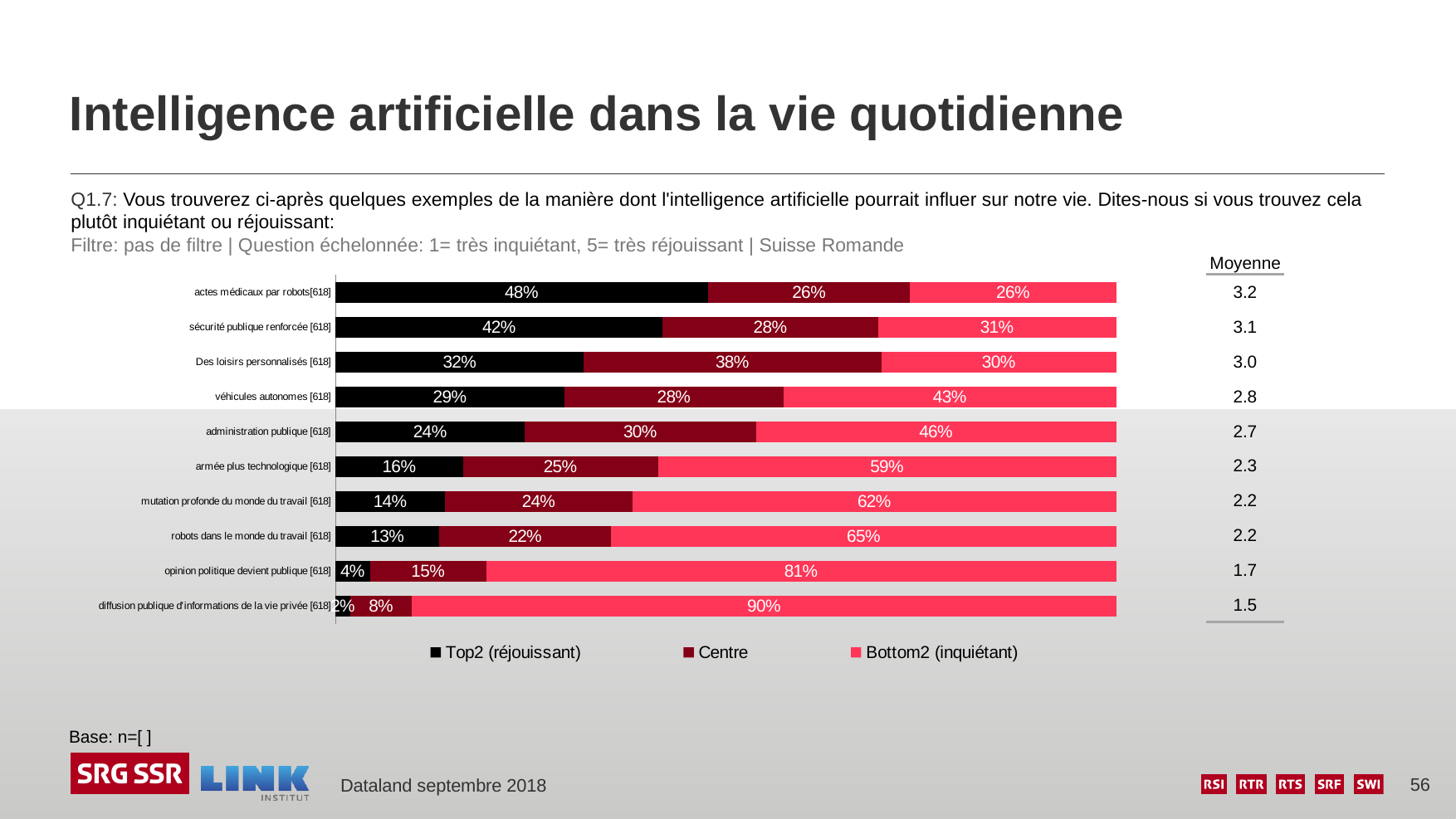
What is the Moyenne value shown for "robots dans le monde du travail"? 2.2 Which is larger: the Top2 (réjouissant) value for "sécurité publique renforcée" or for "administration publique"? sécurité publique renforcée What is the Bottom2 (inquiétant) value for "véhicules autonomes"? 43% What kind of chart is shown on the slide? stacked bar chart What is the Top2 (réjouissant) value for "actes médicaux par robots"? 48% How many categories are plotted in the chart? 10 What is the Centre value for "Des loisirs personnalisés"? 38% Which category has the highest Bottom2 (inquiétant) value? diffusion publique d'informations de la vie privée What is the difference between the Bottom2 (inquiétant) values for "opinion politique devient publique" and "armée plus technologique"? 22% How many series does the legend list? 3 Which legend entry is shown in black? Top2 (réjouissant) Which category has the lowest Top2 (réjouissant) value? diffusion publique d'informations de la vie privée